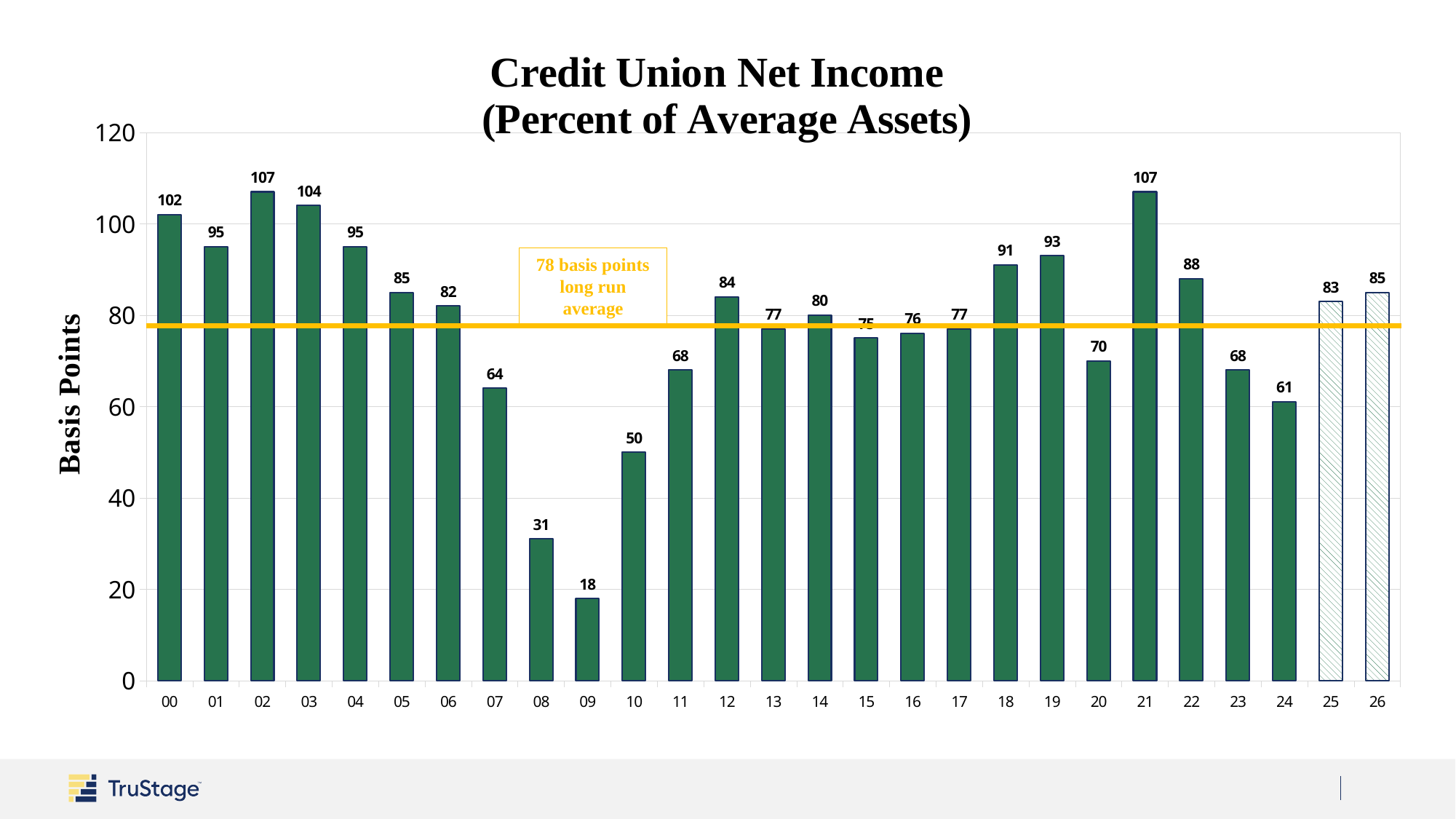
What is the difference between the values for 08 and 09 in the Credit Union Net Income chart? 13 Which is larger in the Credit Union Net Income chart, the value for 19 or the value for 20? 19 What is the value for 24 in the Credit Union Net Income chart? 61 What is the value for 09 in the Credit Union Net Income chart? 18 What is the value for 21 in the Credit Union Net Income chart? 107 What is the difference between the values for 26 and 24 in the Credit Union Net Income chart? 24 What kind of chart is the Credit Union Net Income chart? Bar chart How many years (bars) are shown in the Credit Union Net Income chart? 27 What long run average does the horizontal line in the Credit Union Net Income chart represent? 78 basis points What is the highest value shown in the Credit Union Net Income chart? 107 Which year has the lowest value in the Credit Union Net Income chart? 09 Do the values rise or fall from 06 to 09 in the Credit Union Net Income chart? Fall